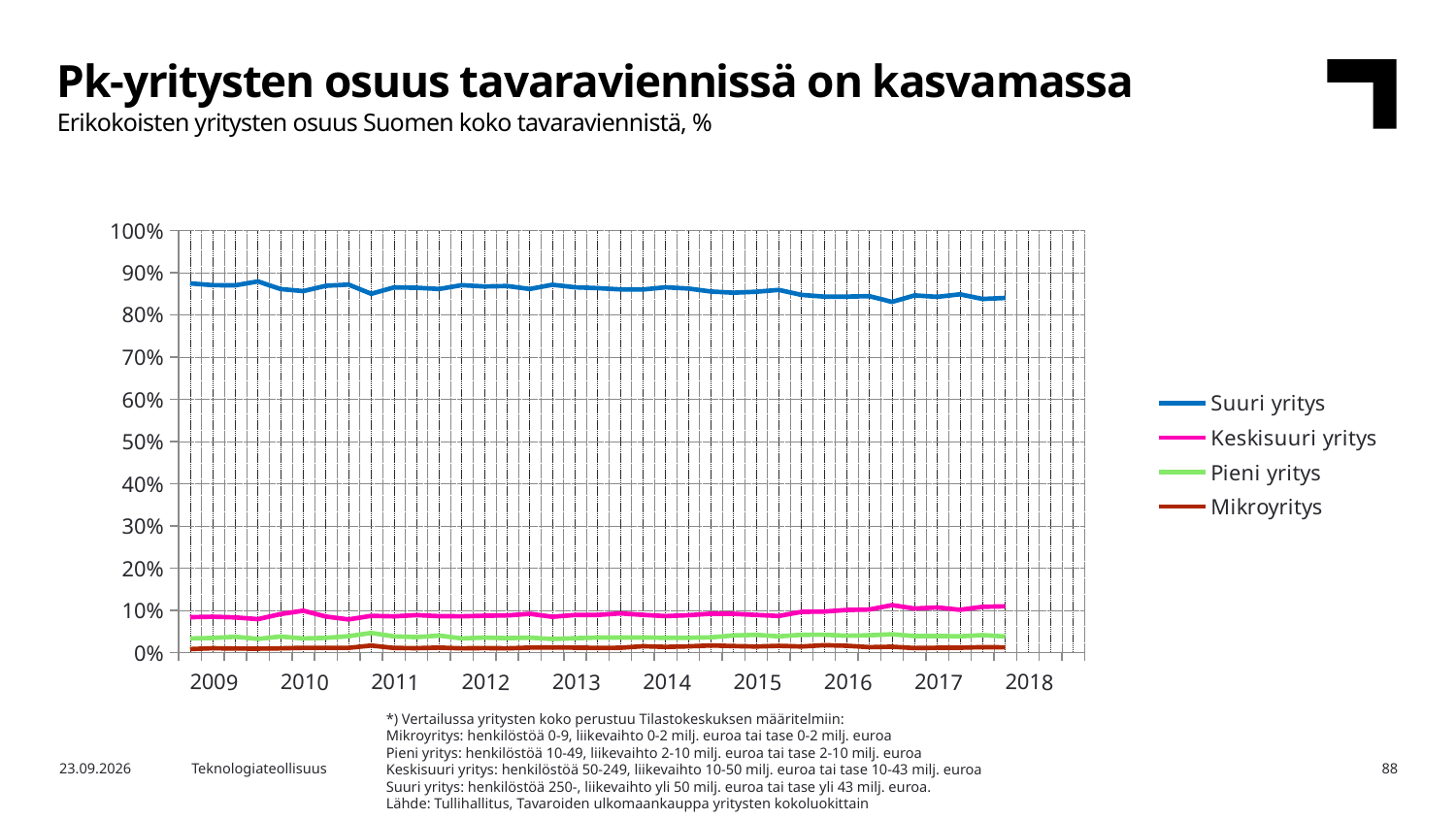
Is the value for Suuri yritys in 2017 greater or less than 90%? less Which series has larger values, Keskisuuri yritys or Pieni yritys? Keskisuuri yritys Which series has the highest values throughout the chart? Suuri yritys What kind of chart is shown on the slide? line chart How many years are labelled on the x axis? 10 Which series has the lowest values throughout the chart? Mikroyritys Which series is drawn in blue? Suuri yritys How many series does the legend list? 4 Does the Keskisuuri yritys line rise or fall overall from 2009 to 2017? rise Does the Suuri yritys line rise or fall overall from 2009 to 2017? fall Is the value for Suuri yritys in 2009 greater or less than 80%? greater Is the value for Keskisuuri yritys in 2017 greater or less than 20%? less